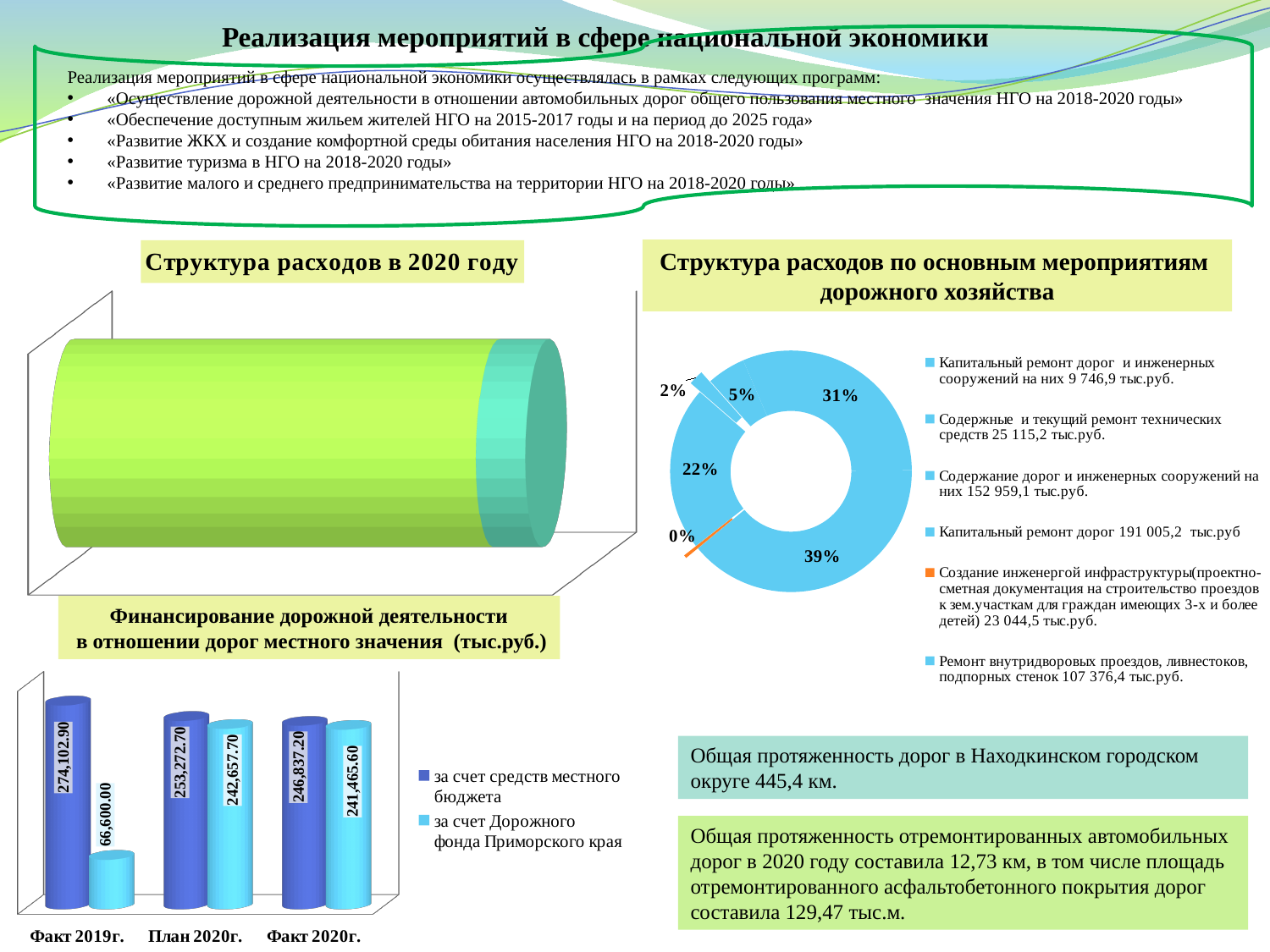
In the chart 'Финансирование дорожной деятельности в отношении дорог местного значения (тыс.руб.)', does the value for 'за счет средств местного бюджета' rise or fall from Факт 2019г. to Факт 2020г.? fall In the chart 'Финансирование дорожной деятельности в отношении дорог местного значения (тыс.руб.)', how many series does the legend list? 2 In the chart 'Структура расходов по основным мероприятиям дорожного хозяйства', how many entries does the legend list? 6 In the chart 'Финансирование дорожной деятельности в отношении дорог местного значения (тыс.руб.)', which series is larger in Факт 2019г.? за счет средств местного бюджета In the chart 'Финансирование дорожной деятельности в отношении дорог местного значения (тыс.руб.)', in which category is 'за счет средств местного бюджета' highest? Факт 2019г. In the chart 'Финансирование дорожной деятельности в отношении дорог местного значения (тыс.руб.)', in which category is 'за счет Дорожного фонда Приморского края' lowest? Факт 2019г. In the chart 'Финансирование дорожной деятельности в отношении дорог местного значения (тыс.руб.)', what is the value for 'за счет Дорожного фонда Приморского края' in Факт 2020г.? 241,465.60 In the chart 'Финансирование дорожной деятельности в отношении дорог местного значения (тыс.руб.)', what is the difference between 'за счет средств местного бюджета' and 'за счет Дорожного фонда Приморского края' in План 2020г.? 10,615.00 In the chart 'Финансирование дорожной деятельности в отношении дорог местного значения (тыс.руб.)', what is the value for 'за счет Дорожного фонда Приморского края' in Факт 2019г.? 66,600.00 In the chart 'Финансирование дорожной деятельности в отношении дорог местного значения (тыс.руб.)', what is the value for 'за счет средств местного бюджета' in Факт 2019г.? 274,102.90 In the chart 'Структура расходов по основным мероприятиям дорожного хозяйства', what is the largest percentage label shown on the chart? 39% In the chart 'Финансирование дорожной деятельности в отношении дорог местного значения (тыс.руб.)', how many categories are shown on the x axis? 3